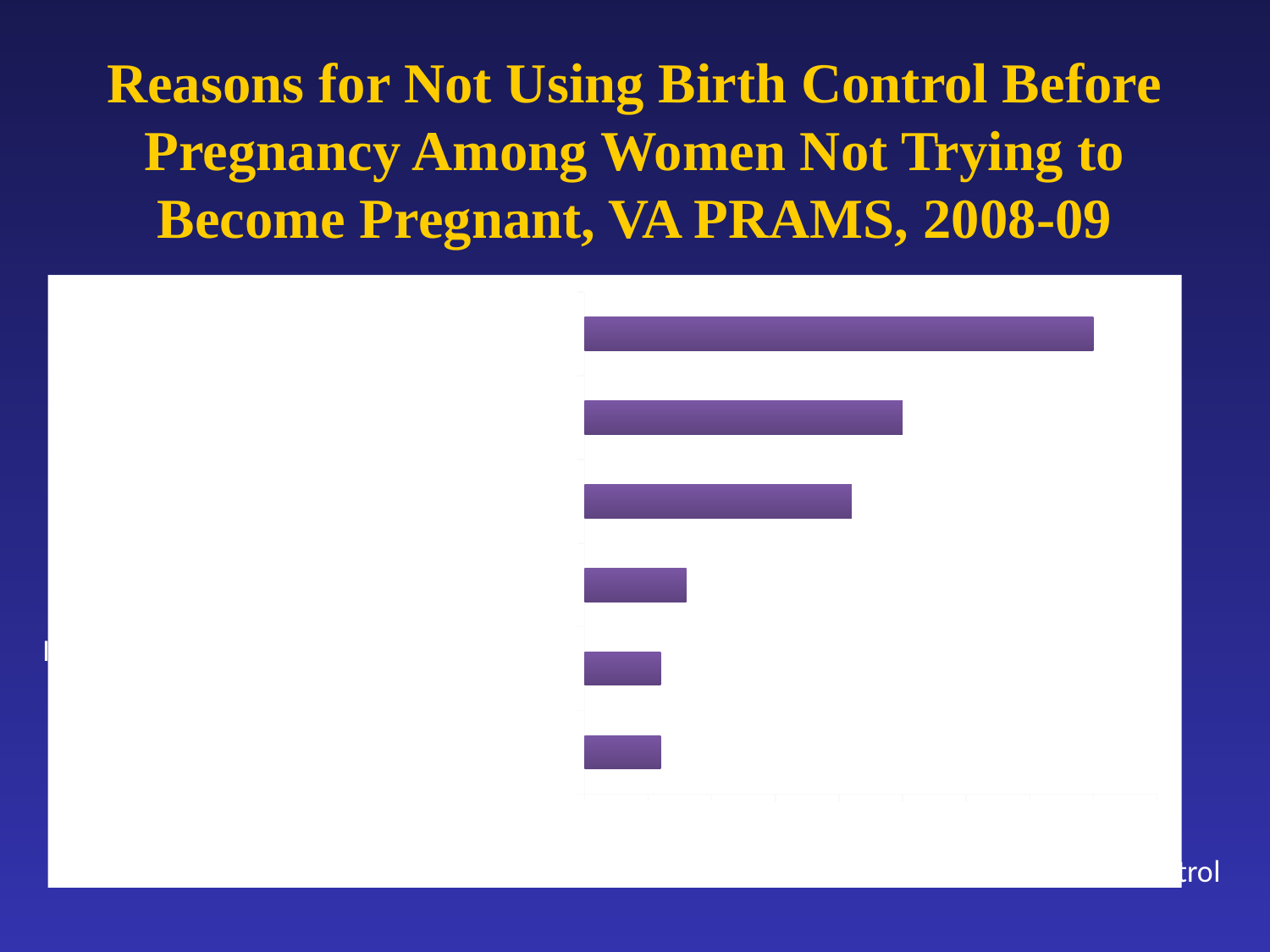
How many bars are plotted in the chart? 6 What kind of chart is shown on the slide? bar chart Which bar is the longest: the top bar or the bottom bar? the top bar What is the title of the slide containing the chart? Reasons for Not Using Birth Control Before Pregnancy Among Women Not Trying to Become Pregnant, VA PRAMS, 2008-09 What colour are the bars in the chart? purple Do the bar lengths increase or decrease going from the top bar to the bottom bar? decrease Are the bars in the chart drawn horizontally or vertically? horizontally Is the second bar from the top longer or shorter than the third bar from the top? longer